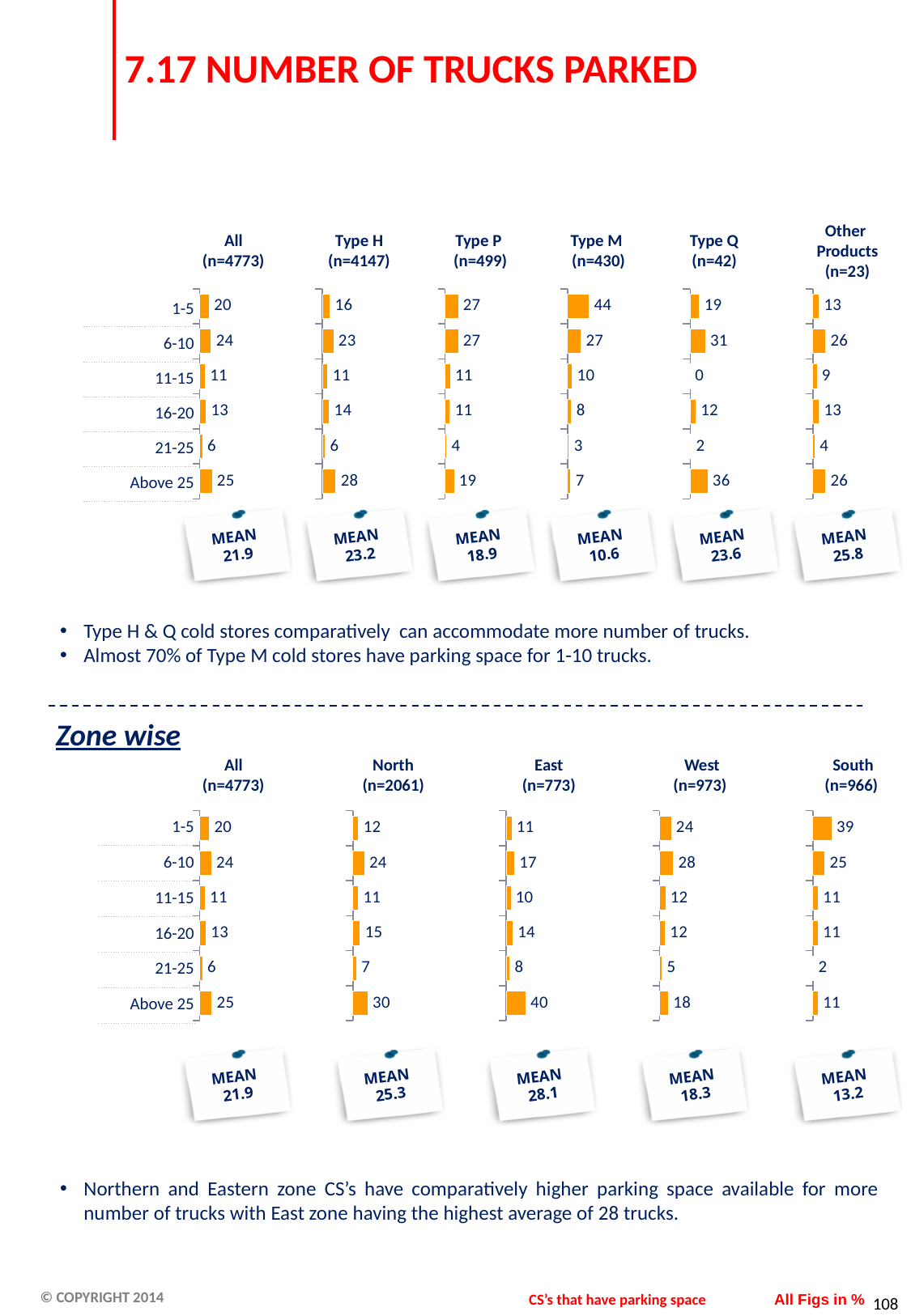
In the Zone wise section, what is the difference between the 1-5 values for South (n=966) and North (n=2061)? 27 In the top section (by type), which category has the lowest value in the Type Q (n=42) chart? 11-15 How many categories does each bar chart in the Zone wise section have? 6 What type of chart is used to show the number of trucks parked for each group? Bar chart In the Zone wise section, what is the value for 1-5 in the South (n=966) chart? 39 In the Zone wise section, what is the value for Above 25 in the East (n=773) chart? 40 In the top section (by type), what is the difference between the 1-5 and 6-10 values in the Type M (n=430) chart? 17 In the Zone wise section, which is larger: the Above 25 value for North (n=2061) or for West (n=973)? North (n=2061) In the top section (by type), which category has the highest value in the Type M (n=430) chart? 1-5 In the Zone wise section, which category has the highest value in the East (n=773) chart? Above 25 In the top section (by type), what is the value for Above 25 in the Type Q (n=42) chart? 36 In the top section (by type), what is the value for the 1-5 category in the Type M (n=430) chart? 44